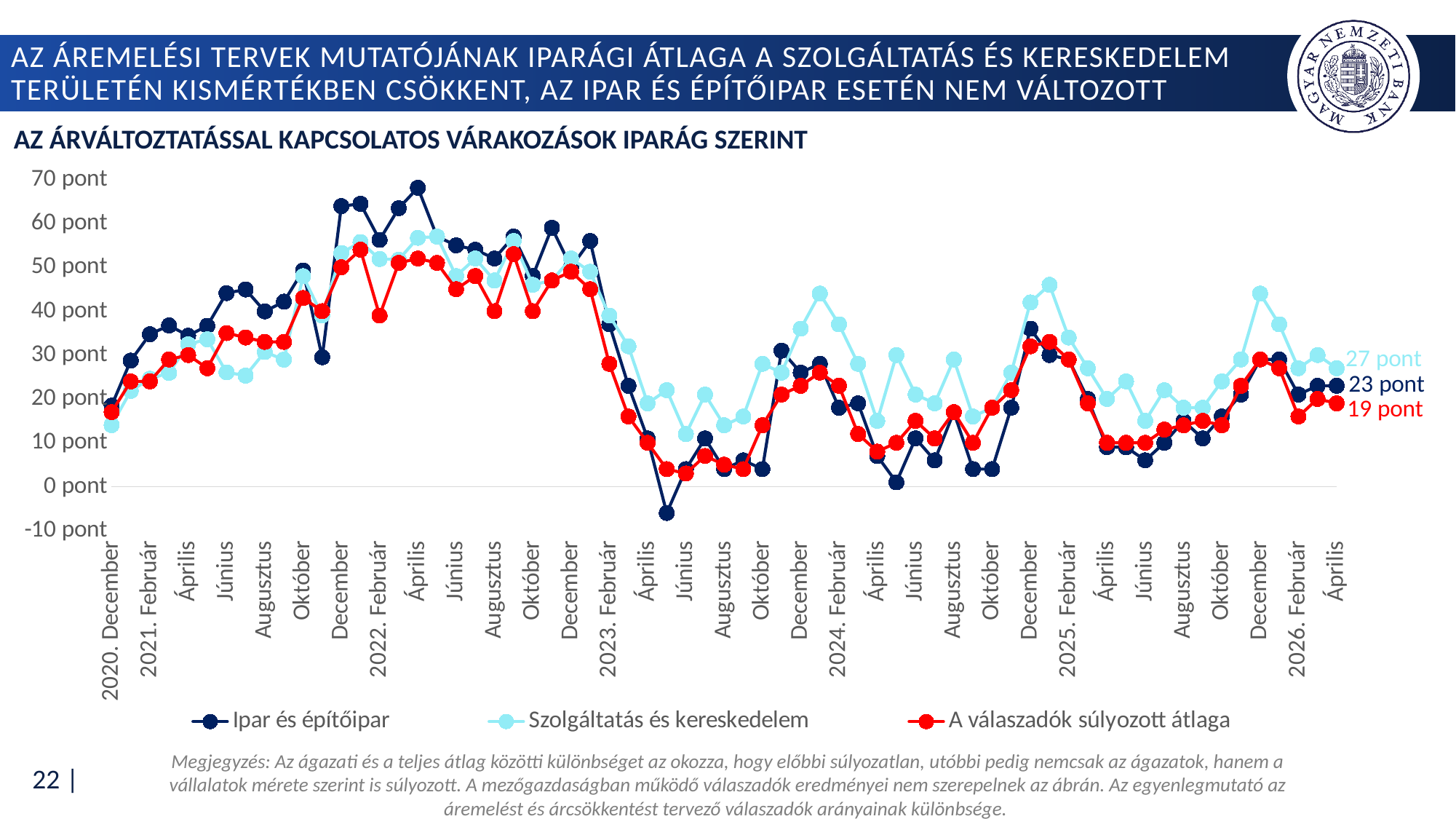
What is the difference between the latest values of Szolgáltatás és kereskedelem and A válaszadók súlyozott átlaga? 8 pont What is the latest value shown for the Szolgáltatás és kereskedelem series? 27 pont What kind of chart is shown on the slide? Line chart At the last data point, which is larger: Ipar és építőipar or A válaszadók súlyozott átlaga? Ipar és építőipar What is the difference between the latest values of Szolgáltatás és kereskedelem and Ipar és építőipar? 4 pont What is the latest value shown for the Ipar és építőipar series? 23 pont At the last data point, which series has the highest value? Szolgáltatás és kereskedelem Is the value for Ipar és építőipar in 2023 Június greater or less than 0 pont? greater At the last data point, which series has the lowest value? A válaszadók súlyozott átlaga Is the value for Ipar és építőipar in 2022 Április greater or less than 60 pont? greater What is the latest value shown for the A válaszadók súlyozott átlaga series? 19 pont How many series does the legend list? 3